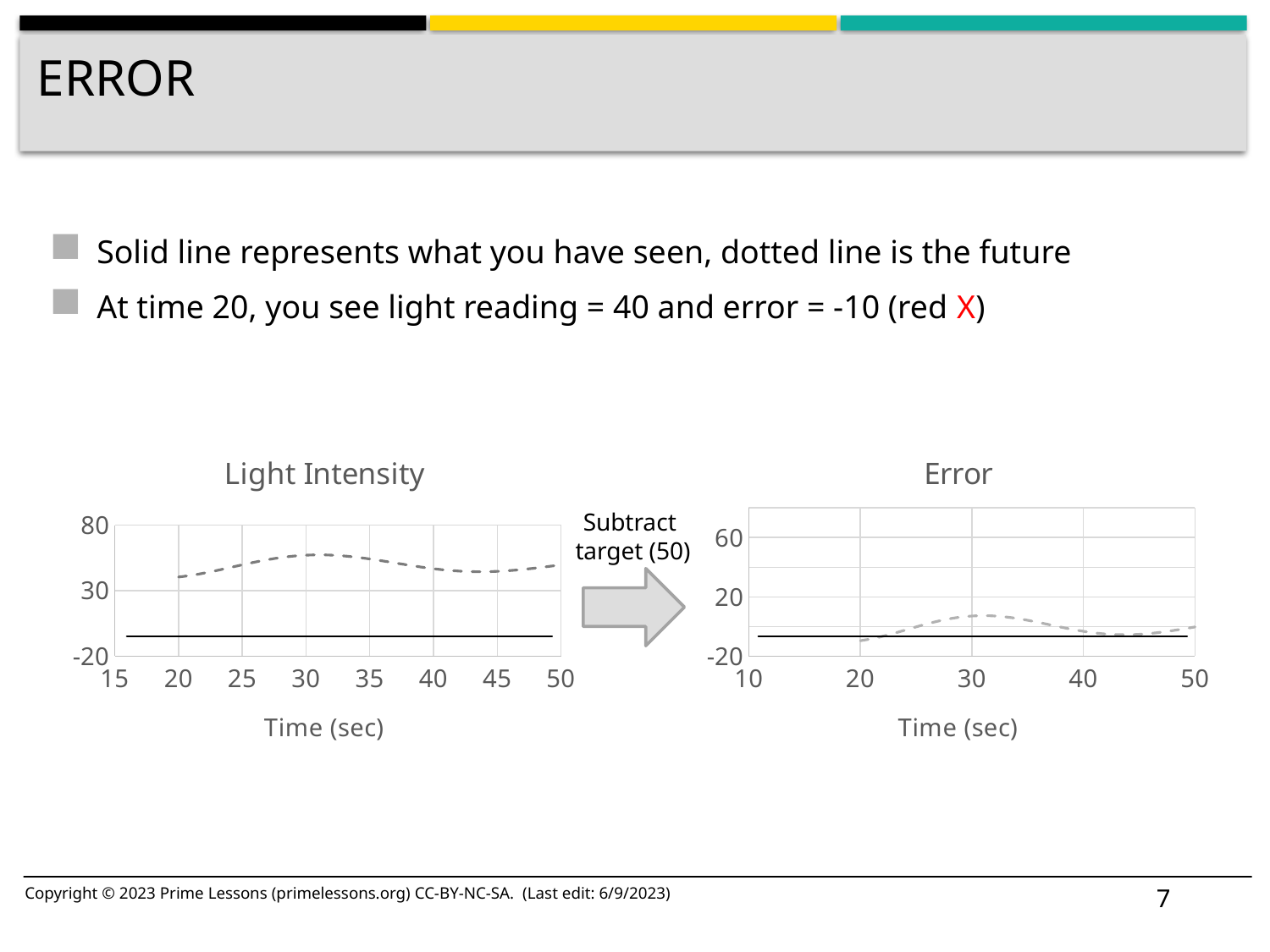
On the Light Intensity chart, does the dotted line rise or fall between time 20 and time 30? rise What kind of chart is the Error chart? line chart On the Error chart, is the dotted line's value at time 20 greater or less than -20? greater On the Light Intensity chart, is the dotted line's value at time 30 greater or less than 30? greater What text is written above the arrow between the two charts? Subtract target (50) On the Error chart, does the dotted line rise or fall between time 30 and time 40? fall On the Error chart, does the dotted line rise or fall between time 20 and time 30? rise On the Light Intensity chart, is the dotted line's value at time 30 greater or less than 80? less What is the x-axis title of the Light Intensity chart? Time (sec) What kind of chart is the Light Intensity chart? line chart